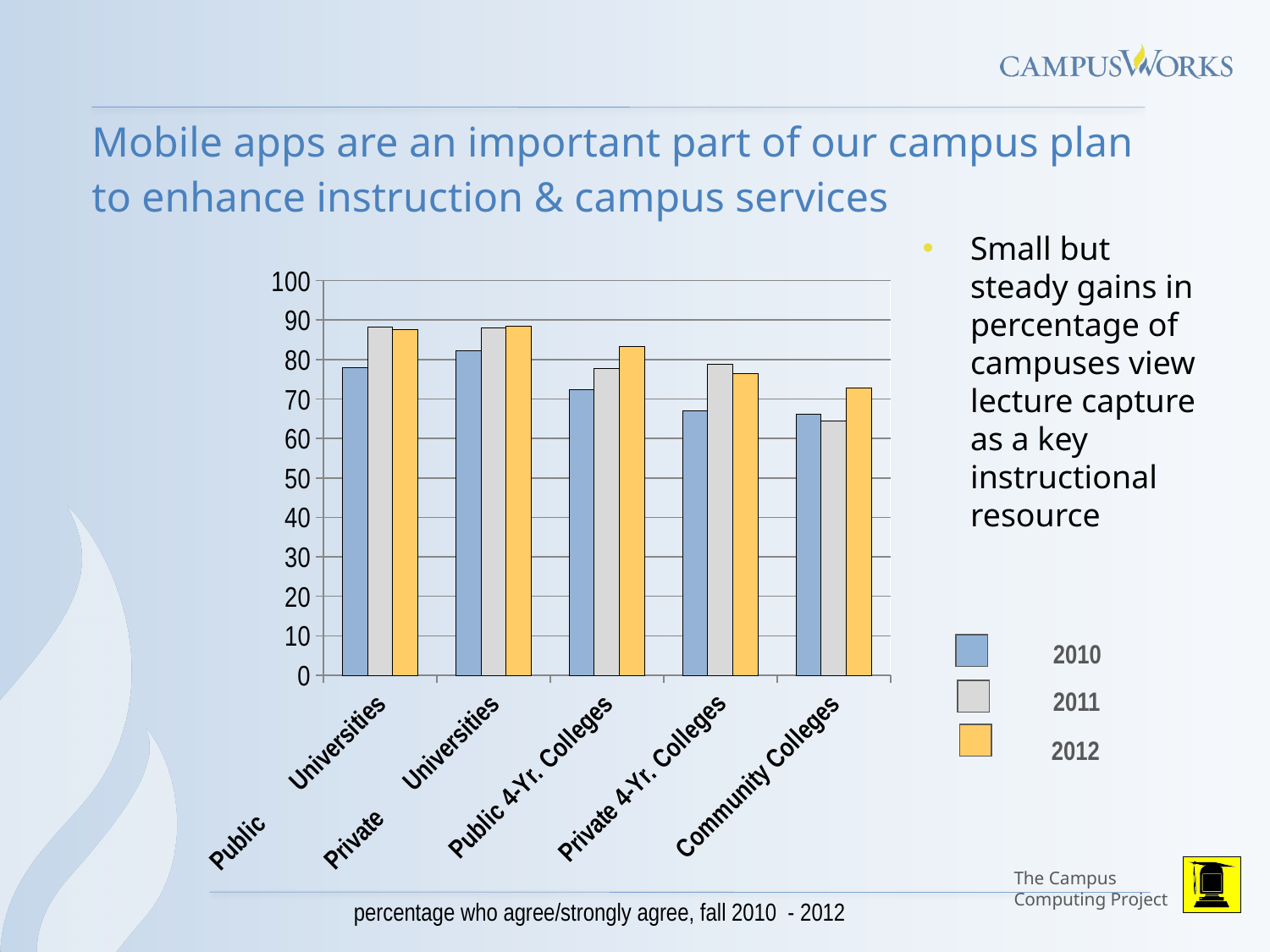
Which years are listed in the chart's legend? 2010, 2011, 2012 For Public 4-Yr. Colleges, which is larger: the 2010 value or the 2012 value? 2012 How many institution categories are shown on the x axis of the chart? 5 Which category has the lowest 2011 bar? Community Colleges For Public 4-Yr. Colleges, do the values rise or fall from 2010 to 2012? rise Is the 2010 value for Public Universities greater or less than 70? greater What kind of chart is shown on the slide? bar chart Is the 2010 value for Private 4-Yr. Colleges greater or less than 70? less Which category has the lowest 2012 bar? Community Colleges Is the 2012 value for Public 4-Yr. Colleges greater or less than 80? greater Which category has the highest 2010 bar? Private Universities How many series does the chart's legend list? 3